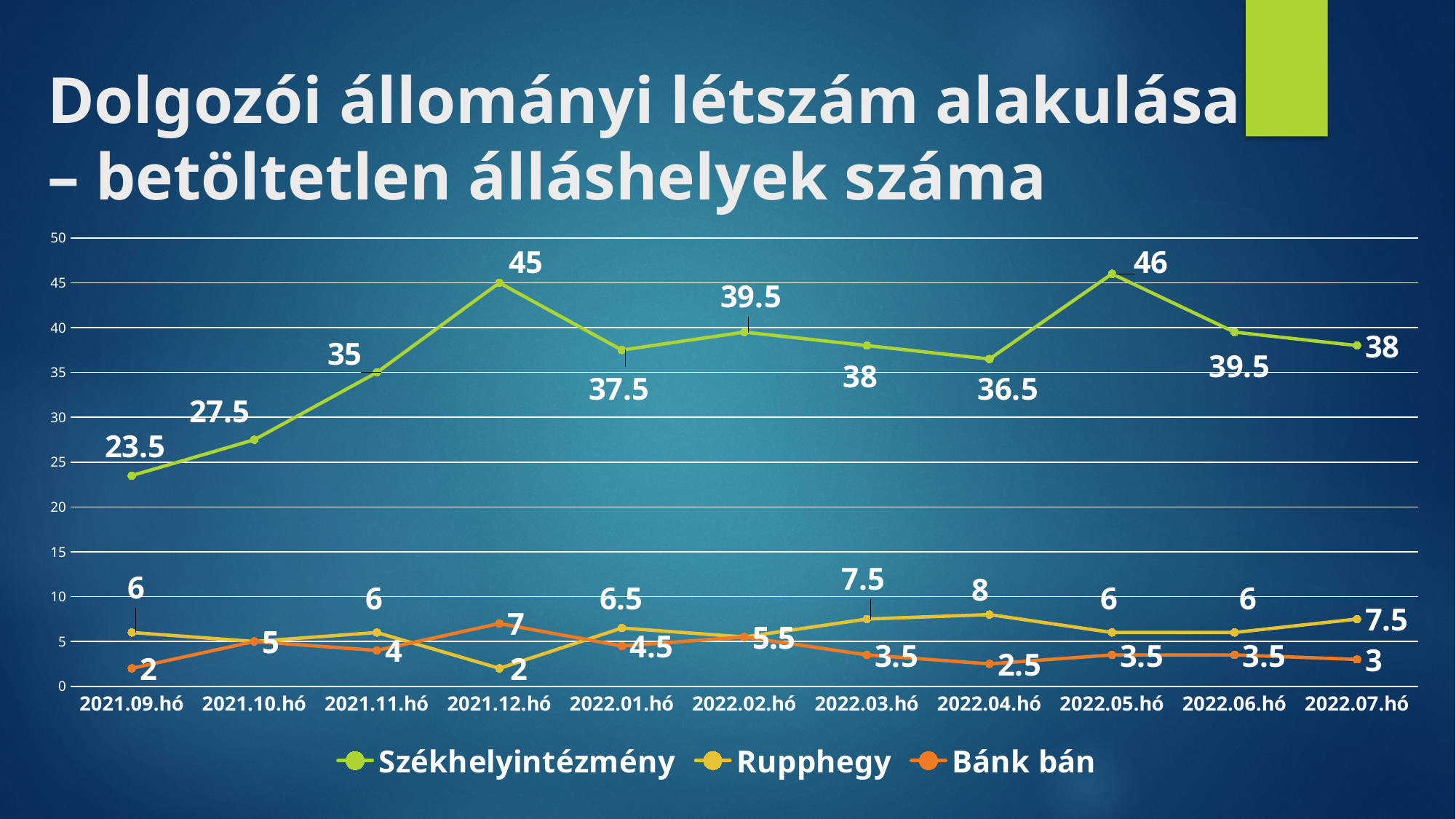
Does the Székhelyintézmény series rise or fall from 2021.09.hó to 2021.12.hó? Rise In which month is the Bánk bán value lowest? 2021.09.hó In which month does the Székhelyintézmény series reach its highest value? 2022.05.hó What kind of chart is shown on the slide? Line chart What is the value for Székhelyintézmény in 2021.12.hó? 45 What is the value for Bánk bán in 2021.12.hó? 7 How many series does the legend list? 3 What is the difference between the Székhelyintézmény values in 2022.05.hó and 2022.04.hó? 9.5 How many months are shown on the x axis? 11 What is the value for Rupphegy in 2022.04.hó? 8 In which month is the Székhelyintézmény value lowest? 2021.09.hó In 2021.12.hó, which is larger: the Rupphegy value or the Bánk bán value? Bánk bán